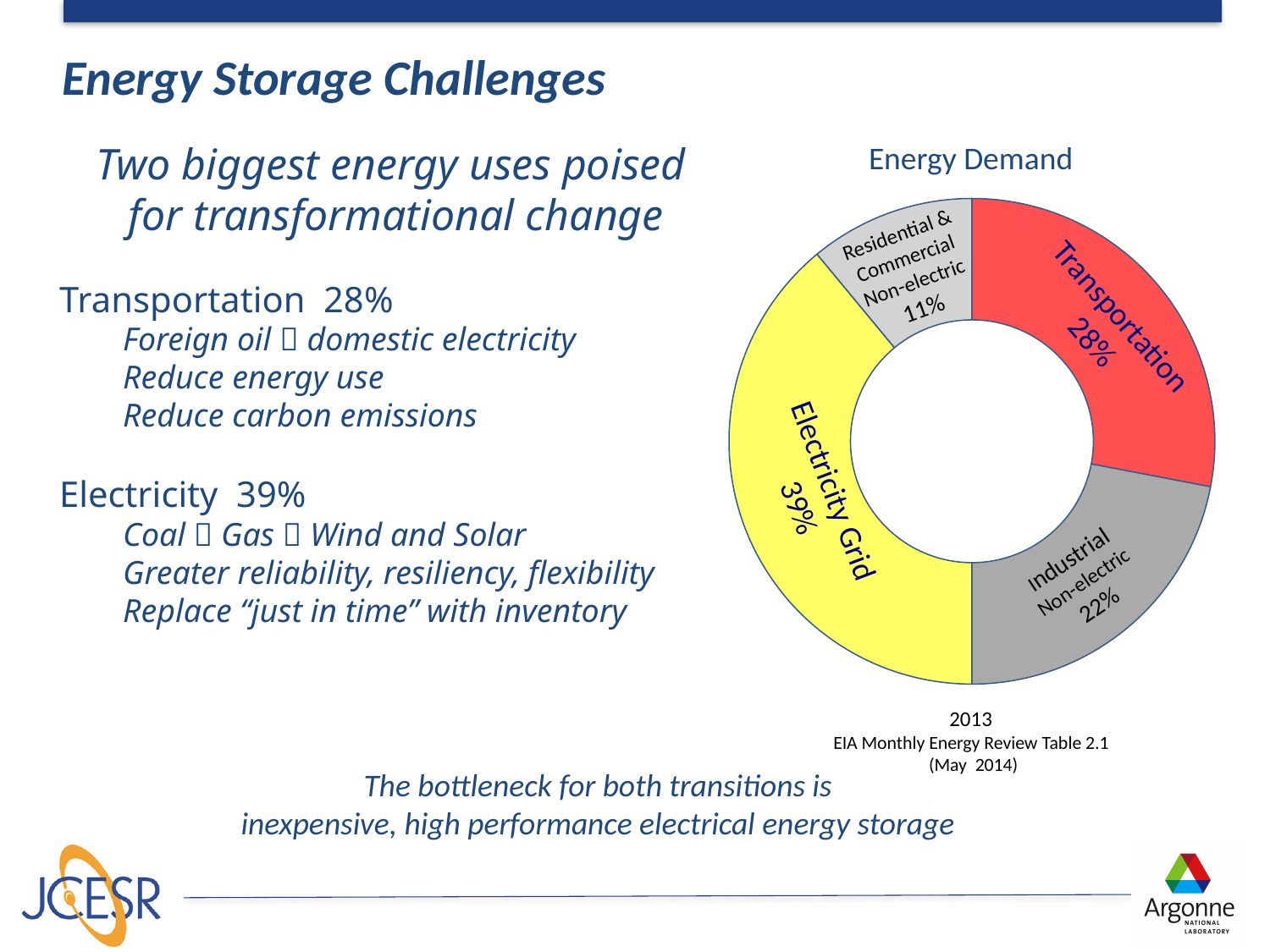
How many categories are shown in the Energy Demand chart? 4 What share of energy demand does the Transportation slice represent? 28% What is the difference in percentage points between the Electricity Grid and Transportation shares? 11 What share of energy demand does the Residential & Commercial Non-electric slice represent? 11% What kind of chart is shown on the slide? Doughnut (pie) chart Which category has the smallest share of energy demand? Residential & Commercial Non-electric What colour is the Electricity Grid slice in the chart? Yellow Which category has the largest share of energy demand? Electricity Grid What is the title of the chart on the slide? Energy Demand What share of energy demand does the Electricity Grid slice represent? 39% Which is larger, the Transportation share or the Industrial Non-electric share? Transportation